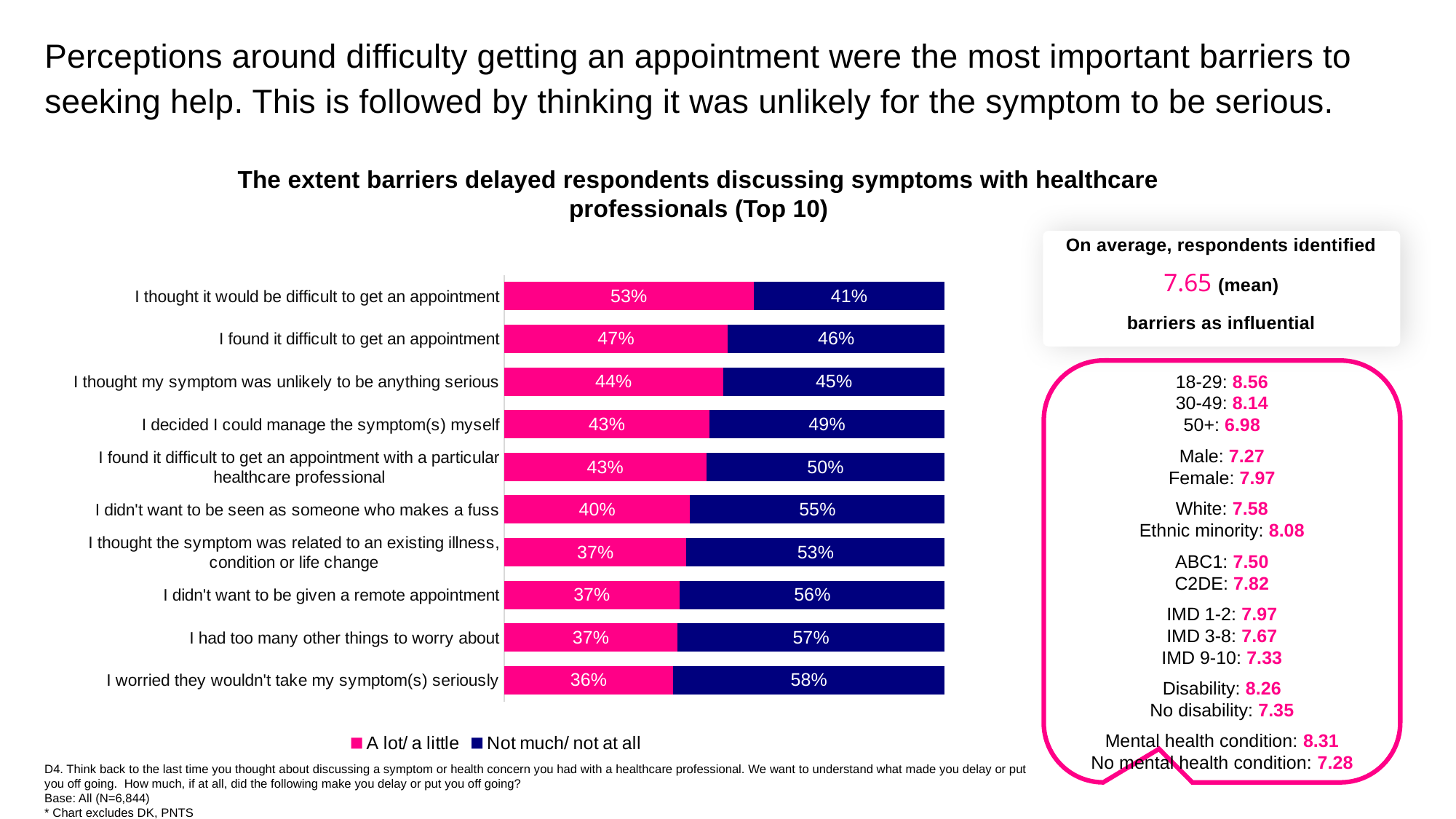
What percentage of respondents said 'I thought it would be difficult to get an appointment' delayed them a lot/a little? 53% Which colour represents 'Not much/ not at all' in the chart? Dark blue What type of chart is shown on the slide? Stacked bar chart Which barrier has the lowest 'A lot/ a little' percentage? I worried they wouldn't take my symptom(s) seriously How many series does the legend list? 2 What is the 'A lot/ a little' value for 'I didn't want to be seen as someone who makes a fuss'? 40% What is the difference between the 'A lot/ a little' and 'Not much/ not at all' values for 'I decided I could manage the symptom(s) myself'? 6 percentage points Which barrier has the highest 'A lot/ a little' percentage? I thought it would be difficult to get an appointment How many barriers are shown in the chart? 10 What is the combined total of the two segments for 'I had too many other things to worry about'? 94% For 'I found it difficult to get an appointment', which is larger: 'A lot/ a little' or 'Not much/ not at all'? A lot/ a little What is the 'Not much/ not at all' value for 'I worried they wouldn't take my symptom(s) seriously'? 58%